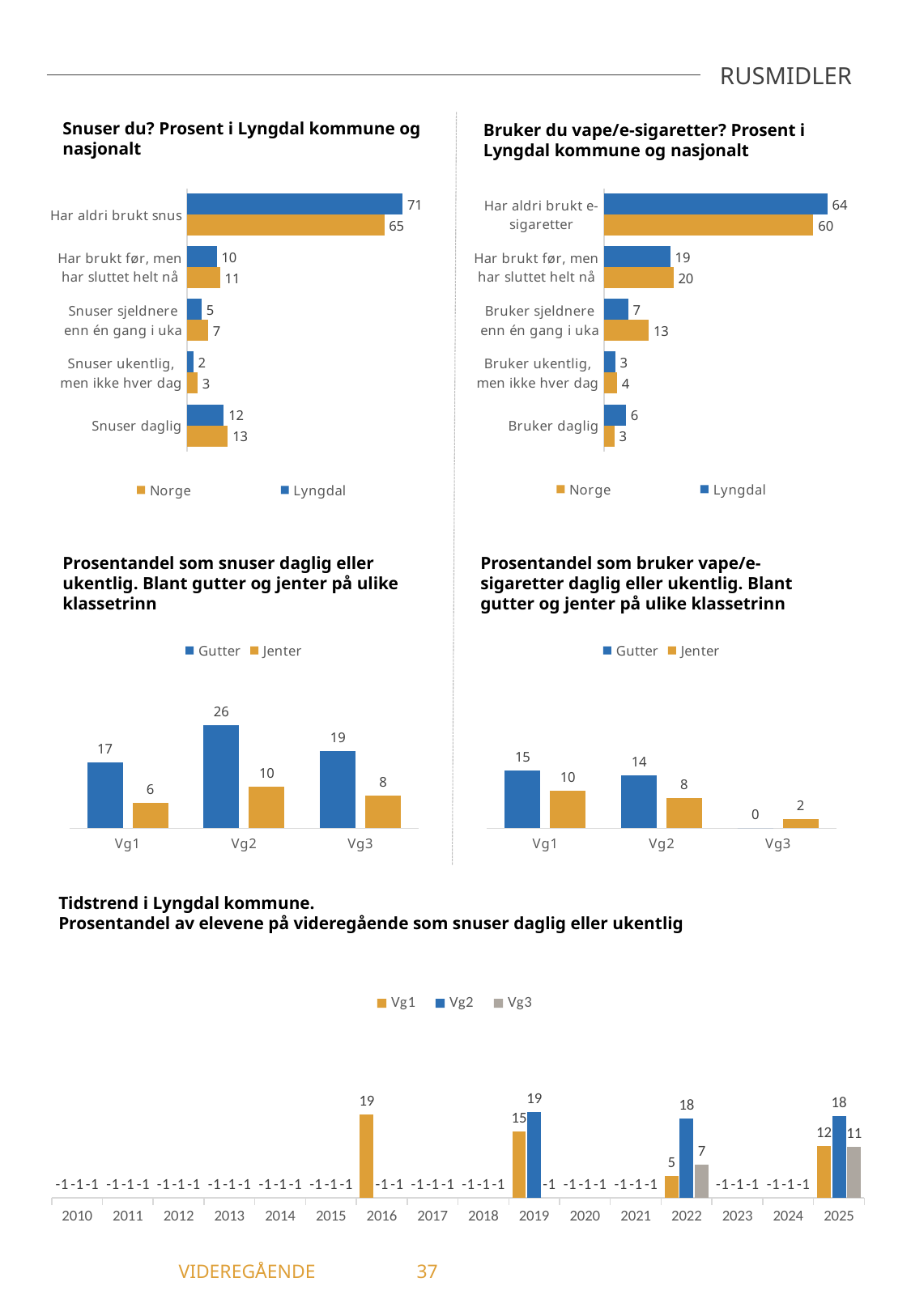
In the chart 'Snuser du? Prosent i Lyngdal kommune og nasjonalt', what is the value for Lyngdal in the category 'Har aldri brukt snus'? 71 In the chart 'Prosentandel som snuser daglig eller ukentlig. Blant gutter og jenter på ulike klassetrinn', which class level has the highest value for Gutter? Vg2 In the chart 'Tidstrend i Lyngdal kommune', which series has the lowest value in 2025? Vg3 In the chart 'Bruker du vape/e-sigaretter? Prosent i Lyngdal kommune og nasjonalt', what is the value for Norge in the category 'Bruker sjeldnere enn én gang i uka'? 13 In the chart 'Tidstrend i Lyngdal kommune', what is the value for Vg2 in 2022? 18 In the chart 'Snuser du? Prosent i Lyngdal kommune og nasjonalt', what is the difference between the Norge and Lyngdal values for 'Snuser daglig'? 1 In the chart 'Bruker du vape/e-sigaretter? Prosent i Lyngdal kommune og nasjonalt', which is larger for 'Bruker daglig': Norge or Lyngdal? Lyngdal How many categories are shown in the chart 'Bruker du vape/e-sigaretter? Prosent i Lyngdal kommune og nasjonalt'? 5 In the chart 'Prosentandel som snuser daglig eller ukentlig. Blant gutter og jenter på ulike klassetrinn', what is the difference between Gutter and Jenter at Vg2? 16 In the chart 'Prosentandel som bruker vape/e-sigaretter daglig eller ukentlig. Blant gutter og jenter på ulike klassetrinn', how many series does the legend list? 2 What kind of chart is 'Tidstrend i Lyngdal kommune'? Bar chart In the chart 'Prosentandel som bruker vape/e-sigaretter daglig eller ukentlig. Blant gutter og jenter på ulike klassetrinn', what is the value for Gutter at Vg3? 0